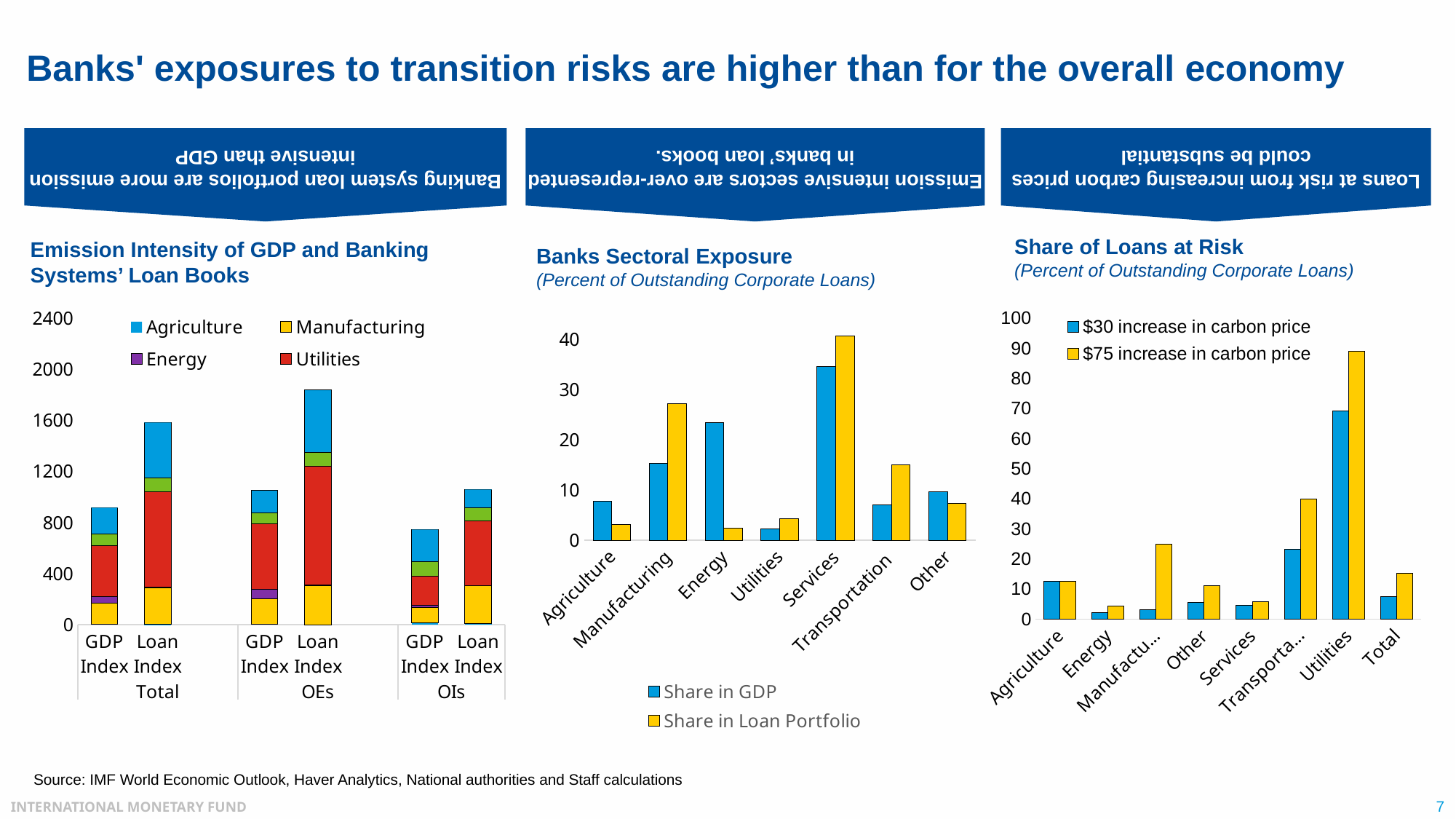
In the 'Emission Intensity of GDP and Banking Systems' Loan Books' chart, which bar is the tallest overall? Loan Index, OEs How many series does the legend of the 'Emission Intensity of GDP and Banking Systems' Loan Books' chart list? 4 In the 'Emission Intensity of GDP and Banking Systems' Loan Books' chart, is the total for the Loan Index under Total greater or less than 1200? greater In the 'Banks Sectoral Exposure' chart, is the Share in Loan Portfolio for Manufacturing greater or less than 20? greater In the 'Banks Sectoral Exposure' chart, for Energy, which is larger: Share in GDP or Share in Loan Portfolio? Share in GDP What type of chart is the 'Emission Intensity of GDP and Banking Systems' Loan Books' chart? stacked bar chart What are the two legend entries in the 'Share of Loans at Risk' chart? $30 increase in carbon price; $75 increase in carbon price In the 'Banks Sectoral Exposure' chart, which category has the highest Share in Loan Portfolio? Services In the 'Banks Sectoral Exposure' chart, which category has the lowest Share in GDP? Utilities In the 'Share of Loans at Risk' chart, which category has the highest value for a $75 increase in carbon price? Utilities How many categories are shown on the x axis of the 'Banks Sectoral Exposure' chart? 7 In the 'Share of Loans at Risk' chart, is the value for Utilities under a $30 increase in carbon price greater or less than 60? greater